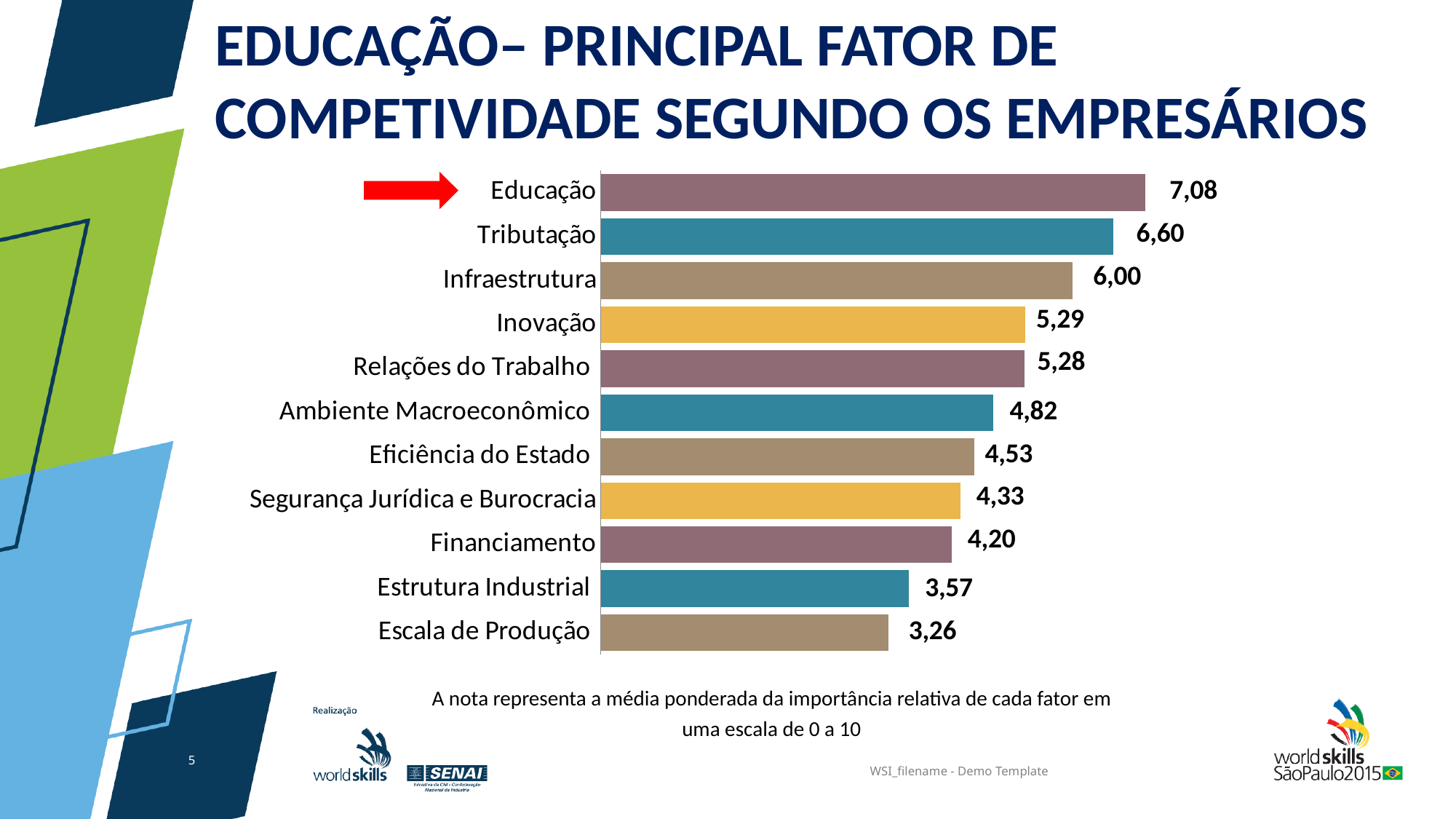
Which category has the highest value? Educação What is the difference between the values for Infraestrutura and Financiamento? 1,80 How many categories are shown in the chart? 11 What is the value for Ambiente Macroeconômico? 4,82 What is the value for Educação? 7,08 Which is larger, the value for Estrutura Industrial or the value for Financiamento? Financiamento What is the value for Escala de Produção? 3,26 What is the difference between the values for Educação and Tributação? 0,48 Which is larger, the value for Eficiência do Estado or the value for Segurança Jurídica e Burocracia? Eficiência do Estado What kind of chart is shown on the slide? Bar chart Which category has the lowest value? Escala de Produção Which category does the red arrow point to? Educação